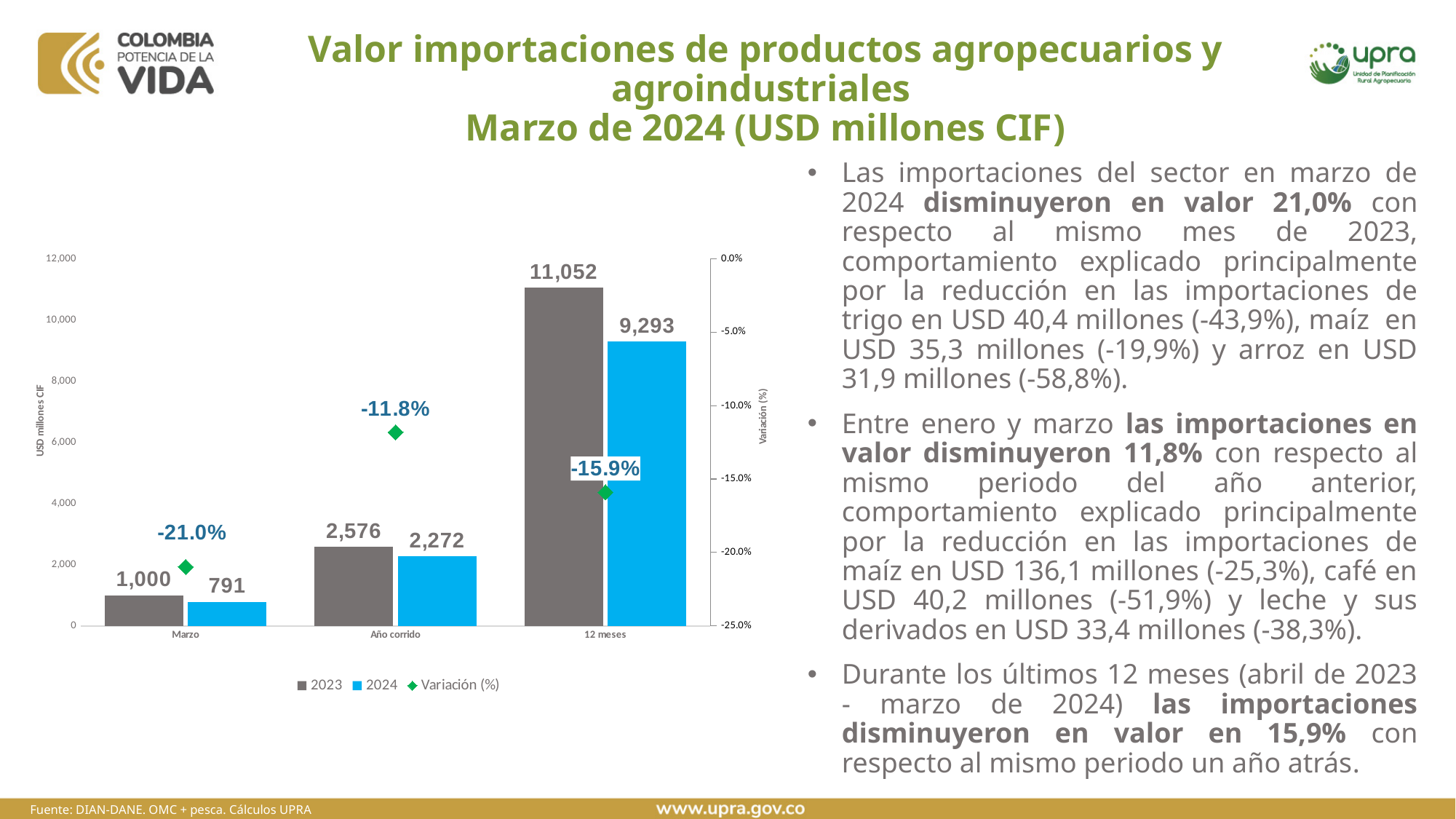
What is the difference between the 2023 and 2024 values for 12 meses? 1,759 What is the 2023 value for Marzo? 1,000 What is the 2024 value for 12 meses? 9,293 How many series does the legend list? 3 What kind of chart is used for the 2023 and 2024 series? bar chart What is the difference between the 2023 and 2024 values for Año corrido? 304 What is the Variación (%) for Año corrido? -11.8% What is the label of the left vertical axis? USD millones CIF Which category has the lowest 2024 value? Marzo Which is larger for Marzo, the 2023 value or the 2024 value? 2023 Which category has the highest 2023 value? 12 meses How many categories are shown on the x axis? 3